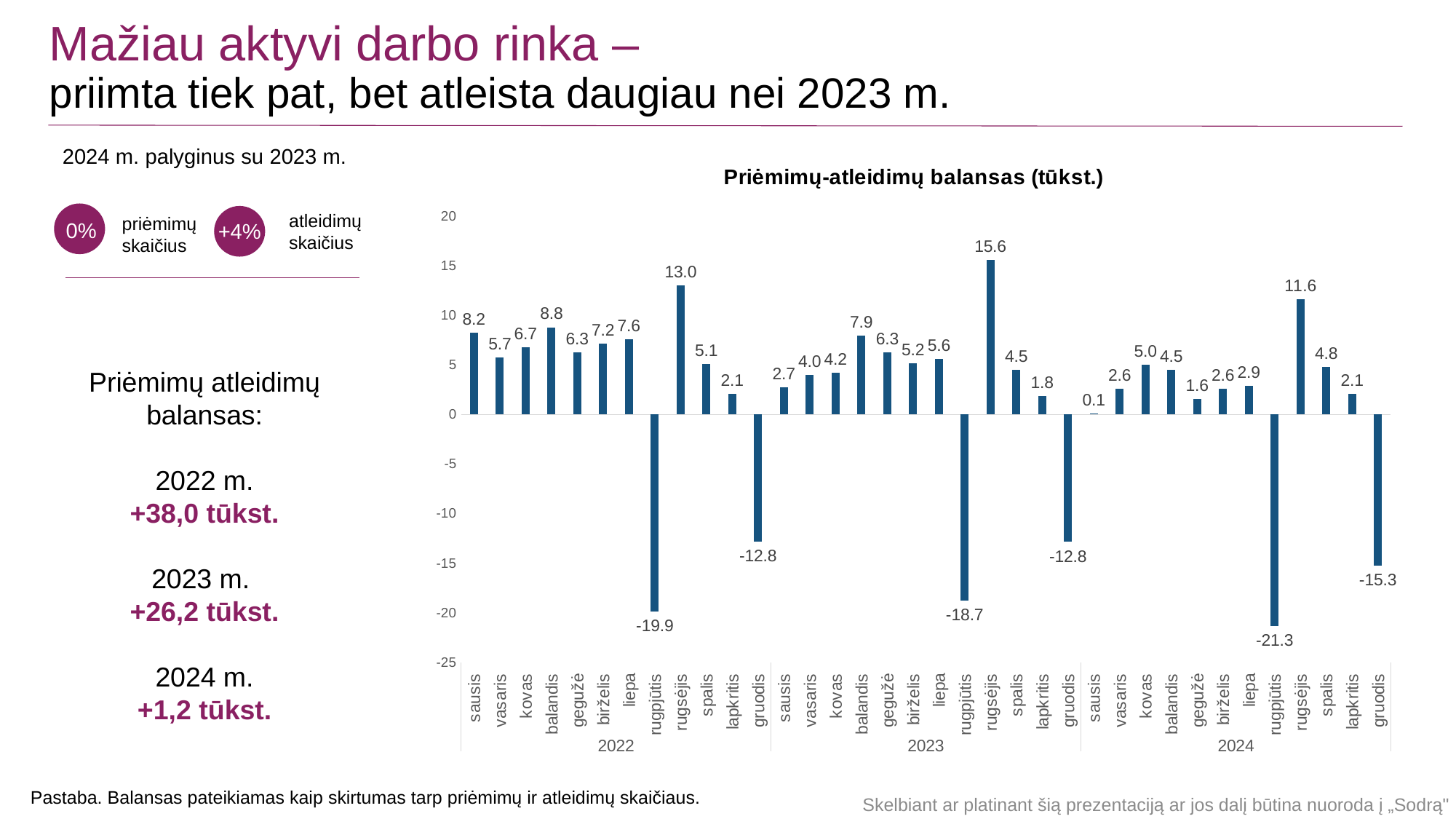
What is the value for gruodis 2024 in the Priėmimų-atleidimų balansas chart? -15.3 What is the title of the chart on the slide? Priėmimų-atleidimų balansas (tūkst.) Is the value for rugpjūtis 2022 in the Priėmimų-atleidimų balansas chart greater or less than -15? less Which is larger in the Priėmimų-atleidimų balansas chart: balandis 2022 or balandis 2023? balandis 2022 What is the value for rugsėjis 2023 in the Priėmimų-atleidimų balansas chart? 15.6 What is the difference between the values for rugsėjis 2022 and rugsėjis 2024 in the Priėmimų-atleidimų balansas chart? 1.4 Which month and year has the highest value in the Priėmimų-atleidimų balansas chart? rugsėjis 2023 What is the value for rugpjūtis 2024 in the Priėmimų-atleidimų balansas chart? -21.3 What is the value for sausis 2022 in the Priėmimų-atleidimų balansas chart? 8.2 What kind of chart is the Priėmimų-atleidimų balansas chart? bar chart Which month and year has the lowest value in the Priėmimų-atleidimų balansas chart? rugpjūtis 2024 How many bars are plotted in the Priėmimų-atleidimų balansas chart? 36